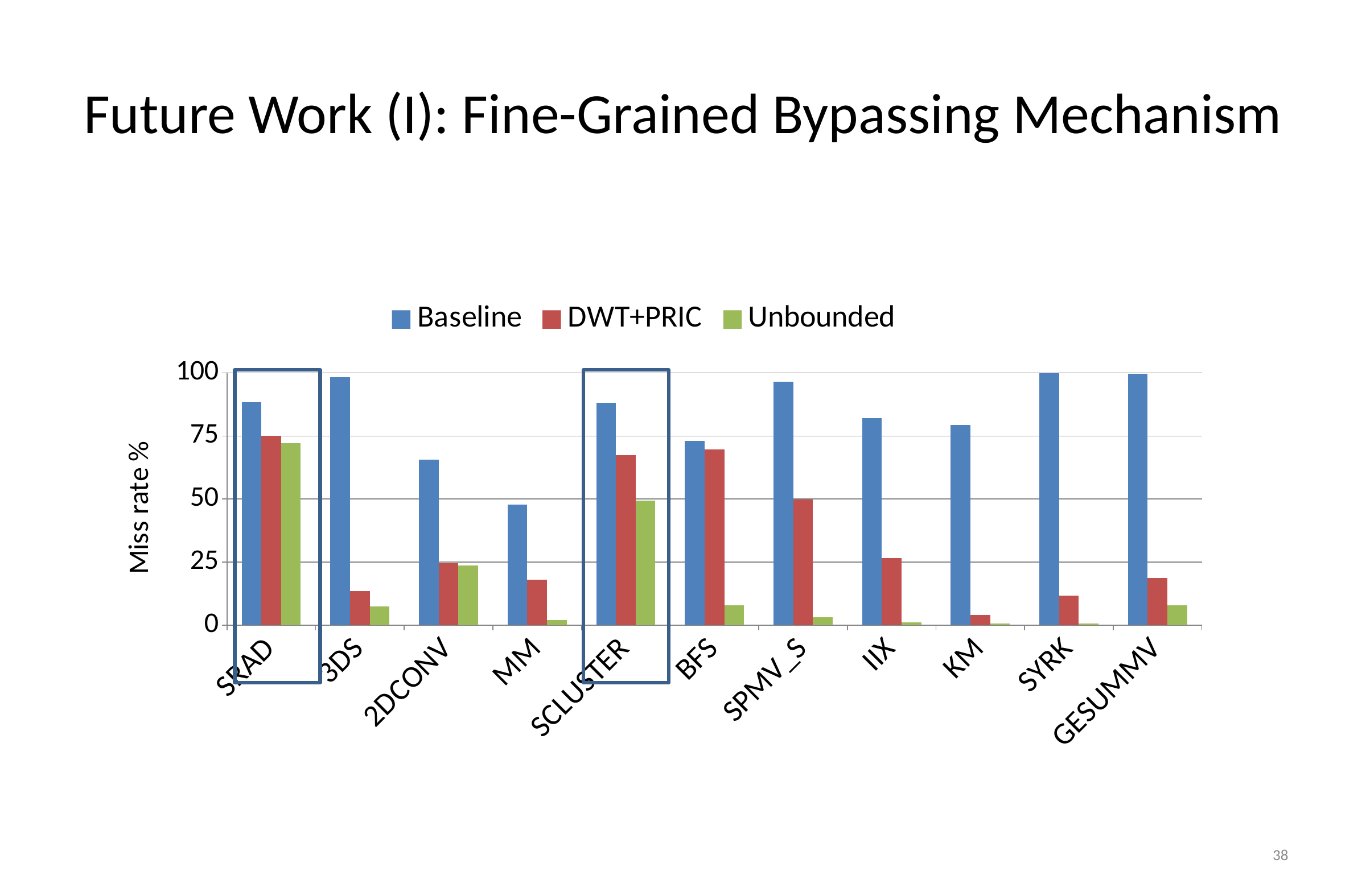
How many benchmark categories are shown on the x axis? 11 Which is larger, the Unbounded value for SCLUSTER or the Unbounded value for BFS? SCLUSTER Which category has the lowest DWT+PRIC miss rate? KM Which category has the lowest Baseline miss rate? MM Which two categories are outlined with a box on the chart? SRAD and SCLUSTER Is the DWT+PRIC value for BFS greater or less than 50? greater Which category has the highest Unbounded miss rate? SRAD Is the Baseline value for 2DCONV greater or less than 50? greater What is the label of the y axis? Miss rate % Is the DWT+PRIC value for 3DS greater or less than 25? less What kind of chart is shown on the slide? bar chart How many series does the legend list? 3